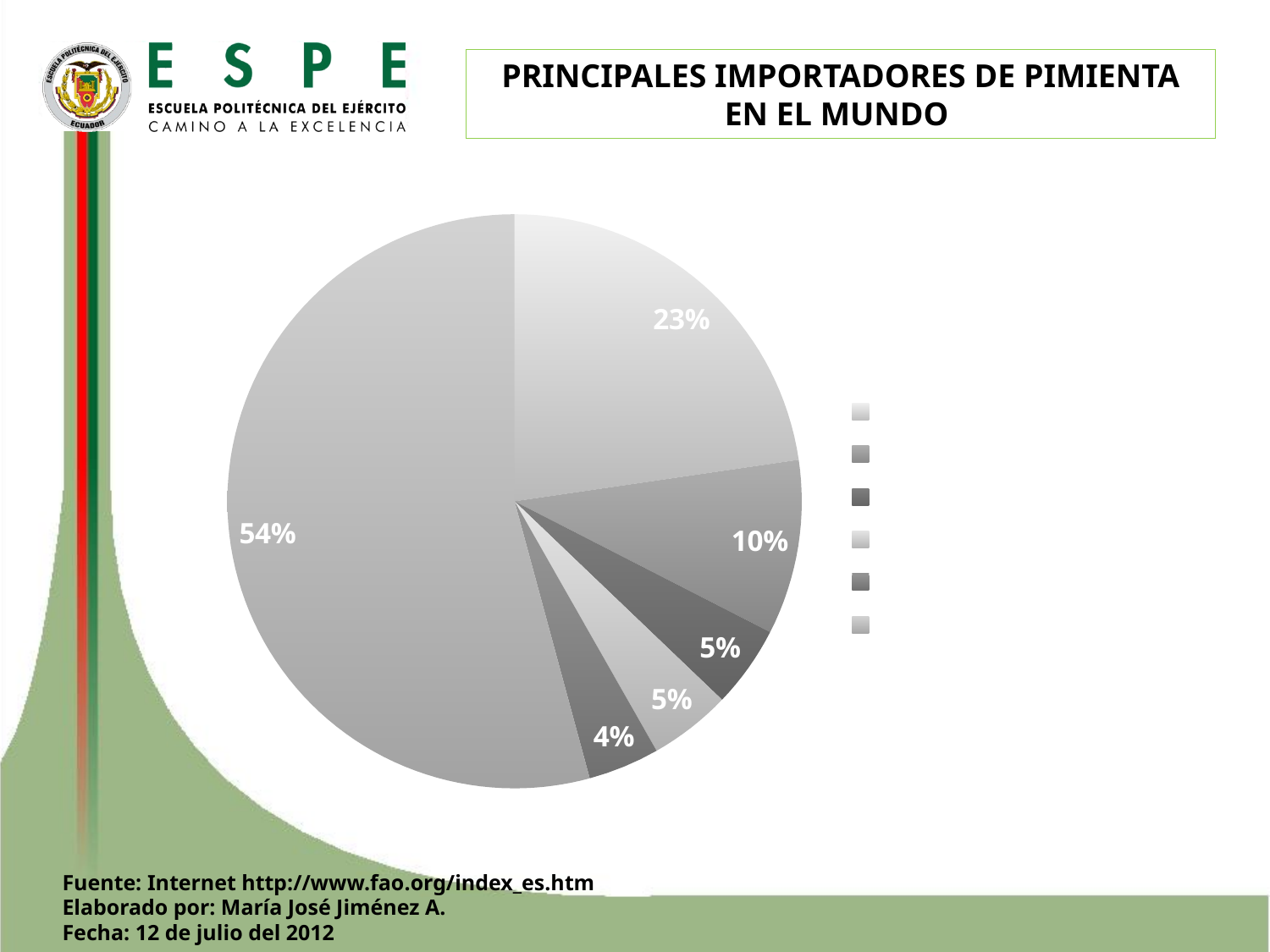
How many entries does the legend of the pie chart list? 6 What is the title of the chart on the slide? PRINCIPALES IMPORTADORES DE PIMIENTA EN EL MUNDO What is the share of the second-largest slice in the pie chart? 23% Which is larger: the slice labelled 10% or the slice labelled 23%? the 23% slice What kind of chart is shown on the slide? pie chart What is the difference in percentage points between the 10% slice and the 4% slice? 6 percentage points What is the share of the largest slice in the pie chart? 54% What is the difference in percentage points between the largest slice (54%) and the second-largest slice (23%)? 31 percentage points Does the largest slice of the pie chart account for more or less than half of the total? more How many slices does the pie chart have? 6 How many slices in the pie chart are labelled 5%? 2 What is the share of the smallest slice in the pie chart? 4%